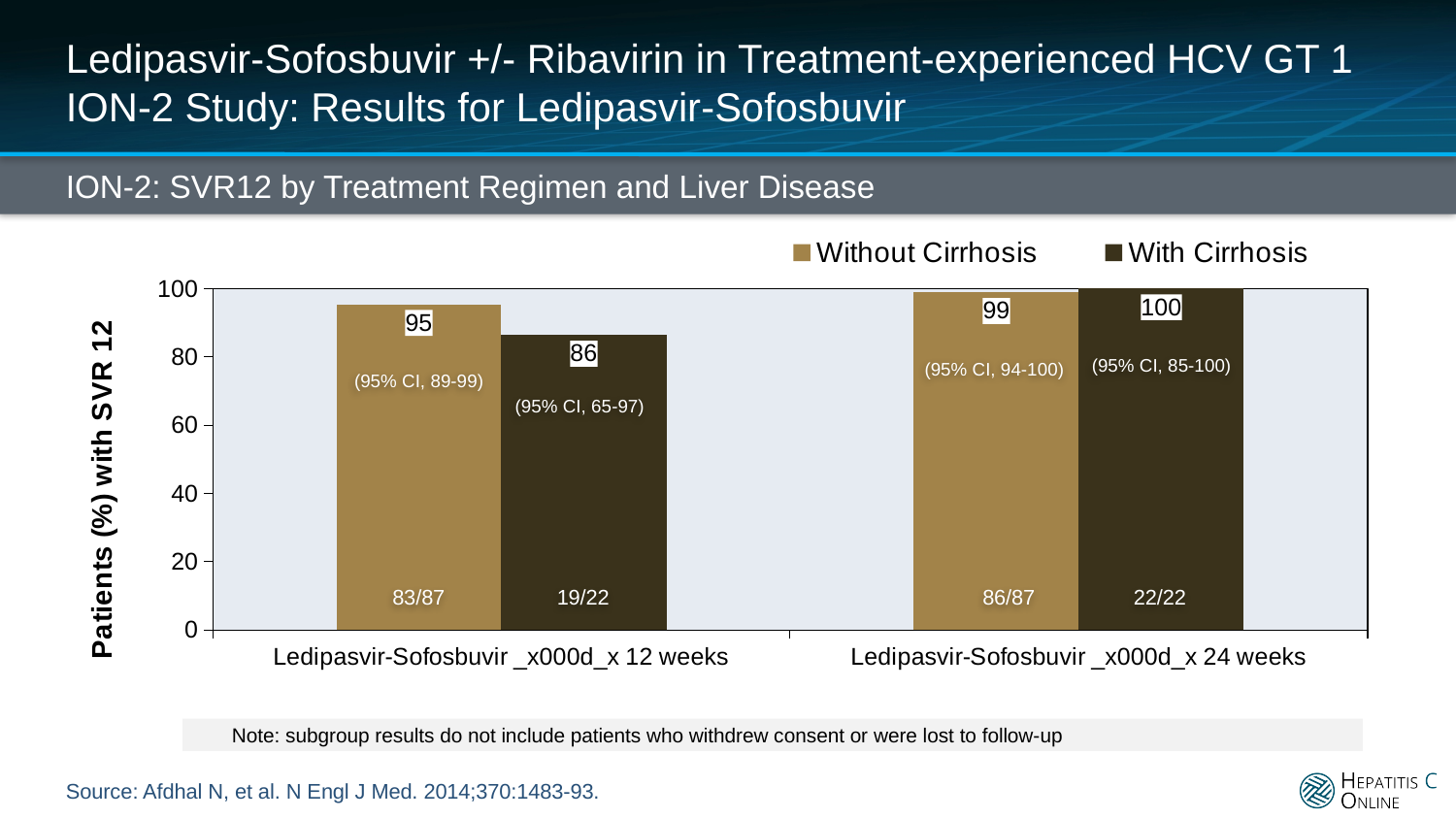
What is the y-axis label of the chart? Patients (%) with SVR 12 What is the 95% confidence interval shown for patients with cirrhosis in the 12-week Ledipasvir-Sofosbuvir group? 95% CI, 65-97 What is the SVR12 rate for patients without cirrhosis treated with Ledipasvir-Sofosbuvir for 12 weeks? 95 What is the SVR12 rate for patients with cirrhosis treated with Ledipasvir-Sofosbuvir for 12 weeks? 86 Which bar shows the lowest SVR12 rate on the chart? With Cirrhosis, Ledipasvir-Sofosbuvir 12 weeks What is the SVR12 rate for patients with cirrhosis treated with Ledipasvir-Sofosbuvir for 24 weeks? 100 How many treatment regimen categories are shown on the x axis? 2 What is the difference in SVR12 rate between patients without cirrhosis and with cirrhosis in the 12-week Ledipasvir-Sofosbuvir group? 9 How many series does the legend list? 2 What is the SVR12 rate for patients without cirrhosis treated with Ledipasvir-Sofosbuvir for 24 weeks? 99 What type of chart is shown on the slide? Bar chart In the 12-week Ledipasvir-Sofosbuvir group, which subgroup had the higher SVR12 rate: without cirrhosis or with cirrhosis? Without Cirrhosis